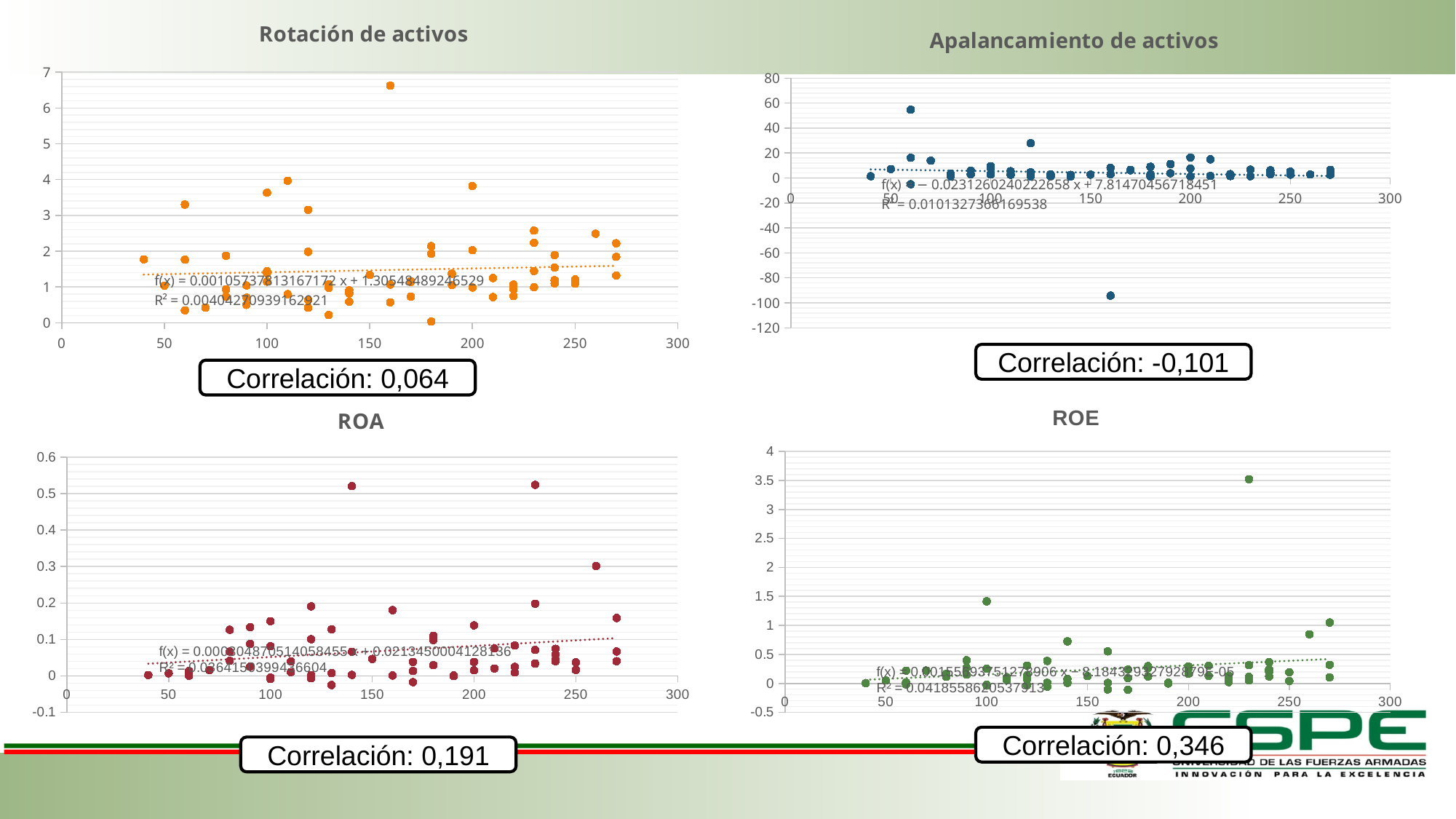
In the 'Apalancamiento de activos' chart, is the lowest plotted point greater or less than -80? less In the 'Apalancamiento de activos' chart, is the highest plotted point greater or less than 40? greater In the 'ROA' chart, is the highest plotted point greater or less than 0.5? greater What kind of chart is the 'Rotación de activos' chart? scatter chart What correlation value is shown below the 'Apalancamiento de activos' chart? -0,101 In the 'Apalancamiento de activos' chart, does the dotted trend line rise or fall as x increases? fall What correlation value is shown below the 'ROE' chart? 0,346 In the 'ROA' chart, does the dotted trend line rise or fall as x increases? rise How many charts are shown on the slide? 4